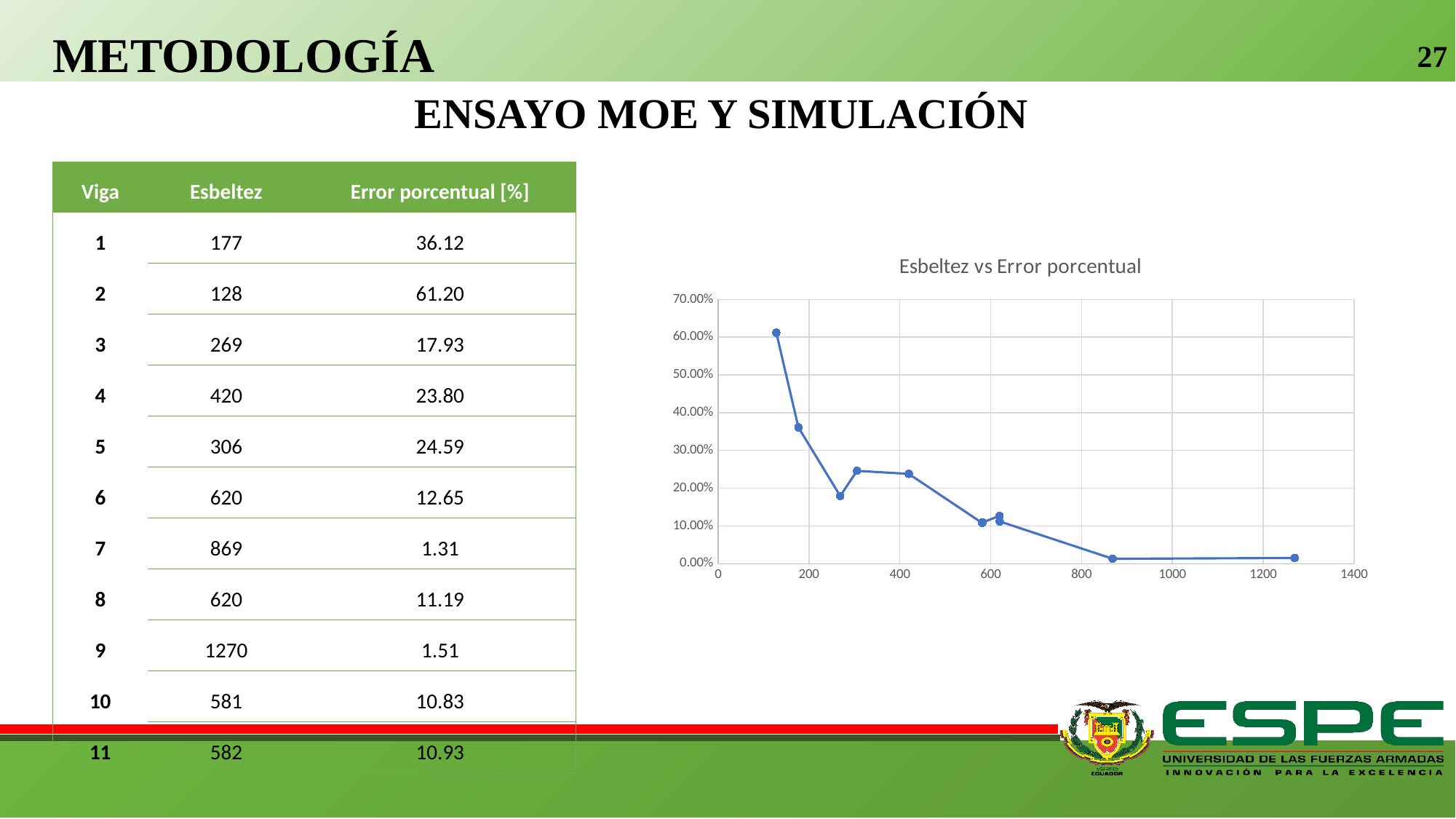
In the chart, is the value of the leftmost point greater or less than 60.00%? greater In the chart, which point has the larger error value, the leftmost point or the rightmost point? the leftmost point What is the highest value shown on the y axis of the chart? 70.00% What is the title of the chart on the slide? Esbeltez vs Error porcentual In the chart, is the value of the point near 200 on the x axis greater or less than 30.00%? greater In the chart, is the value of the point near 400 on the x axis greater or less than 30.00%? less What kind of chart is 'Esbeltez vs Error porcentual'? line chart In the chart, does the error percentage generally rise or fall as esbeltez increases along the x axis? fall